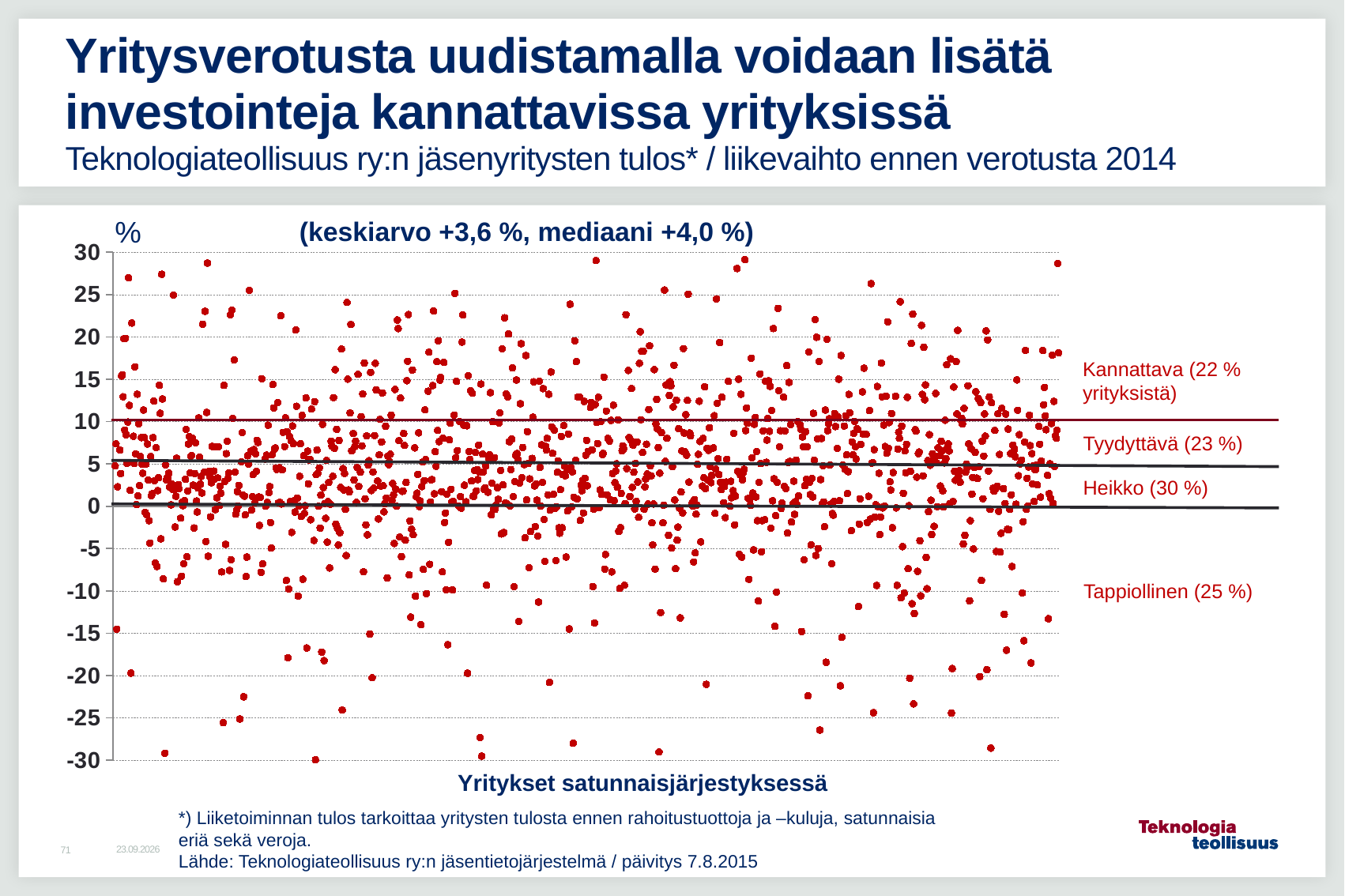
What share of companies is labelled Heikko? 30 % How many percentage points larger is the Heikko share than the Tappiollinen share? 5 What share of companies is labelled Tappiollinen? 25 % What share of companies is labelled Kannattava? 22 % What is the average (keskiarvo) value stated in the chart heading? +3,6 % Which of the four labelled groups has the smallest share of companies? Kannattava What is the label on the x axis of the chart? Yritykset satunnaisjärjestyksessä Which group has a larger share of companies, Tyydyttävä or Tappiollinen? Tappiollinen What kind of chart is shown on the slide? Scatter chart What share of companies is labelled Tyydyttävä? 23 % What is the median (mediaani) value stated in the chart heading? +4,0 % Which of the four labelled groups (Kannattava, Tyydyttävä, Heikko, Tappiollinen) has the largest share of companies? Heikko